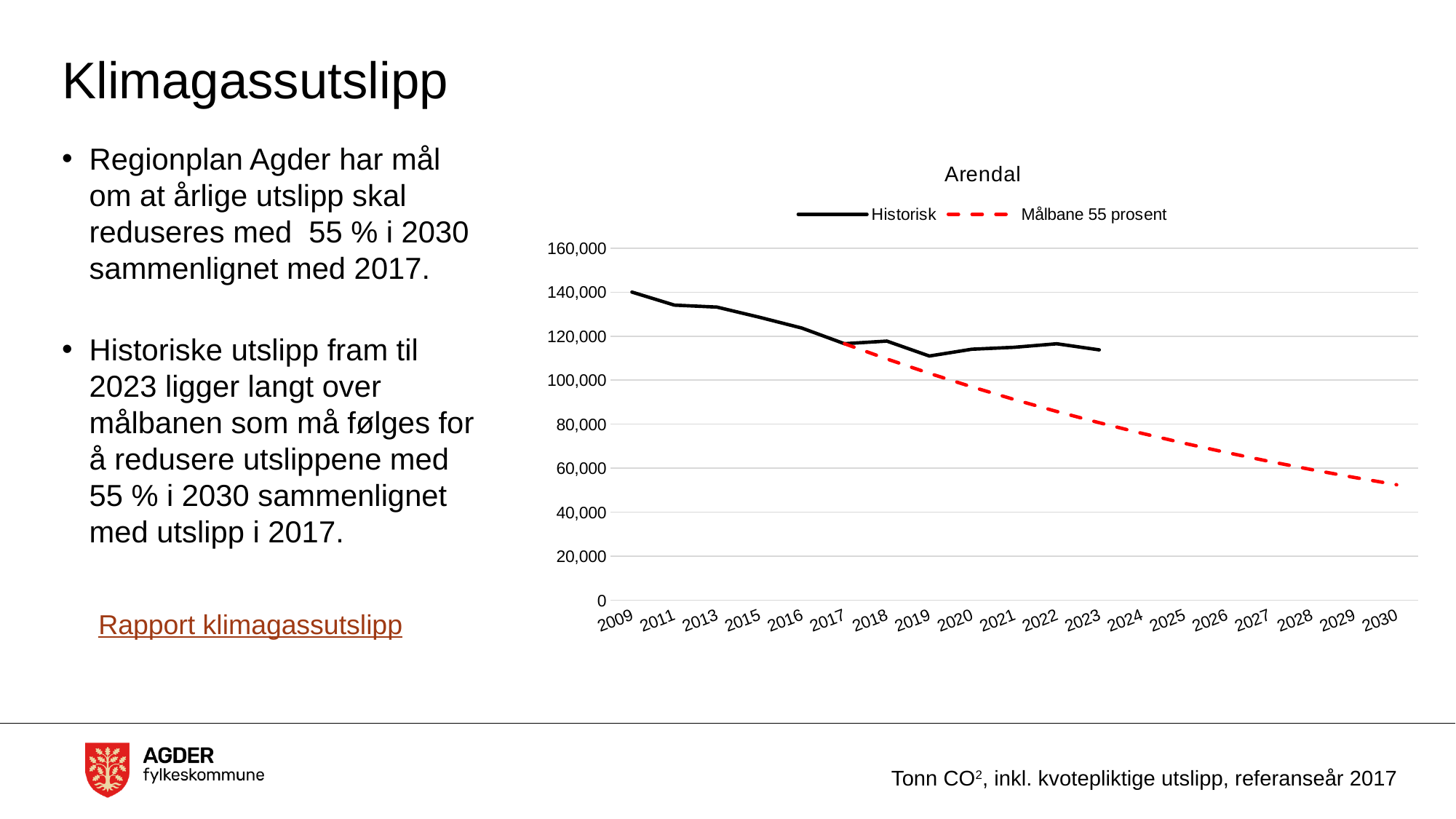
How many series does the chart legend list? 2 Is the Målbane 55 prosent value for 2022 greater or less than 100,000? less Is the Målbane 55 prosent value for 2030 greater or less than 60,000? less What kind of chart is shown on the slide? line chart Does the Målbane 55 prosent line rise or fall from 2017 to 2030? fall Does the Historisk line overall rise or fall from 2009 to 2023? fall Is the Historisk value for 2011 greater or less than 120,000? greater Which series is drawn as a red dashed line? Målbane 55 prosent How many year labels are shown on the x axis? 19 In 2023, which series has the higher value, Historisk or Målbane 55 prosent? Historisk What is the title of the chart? Arendal